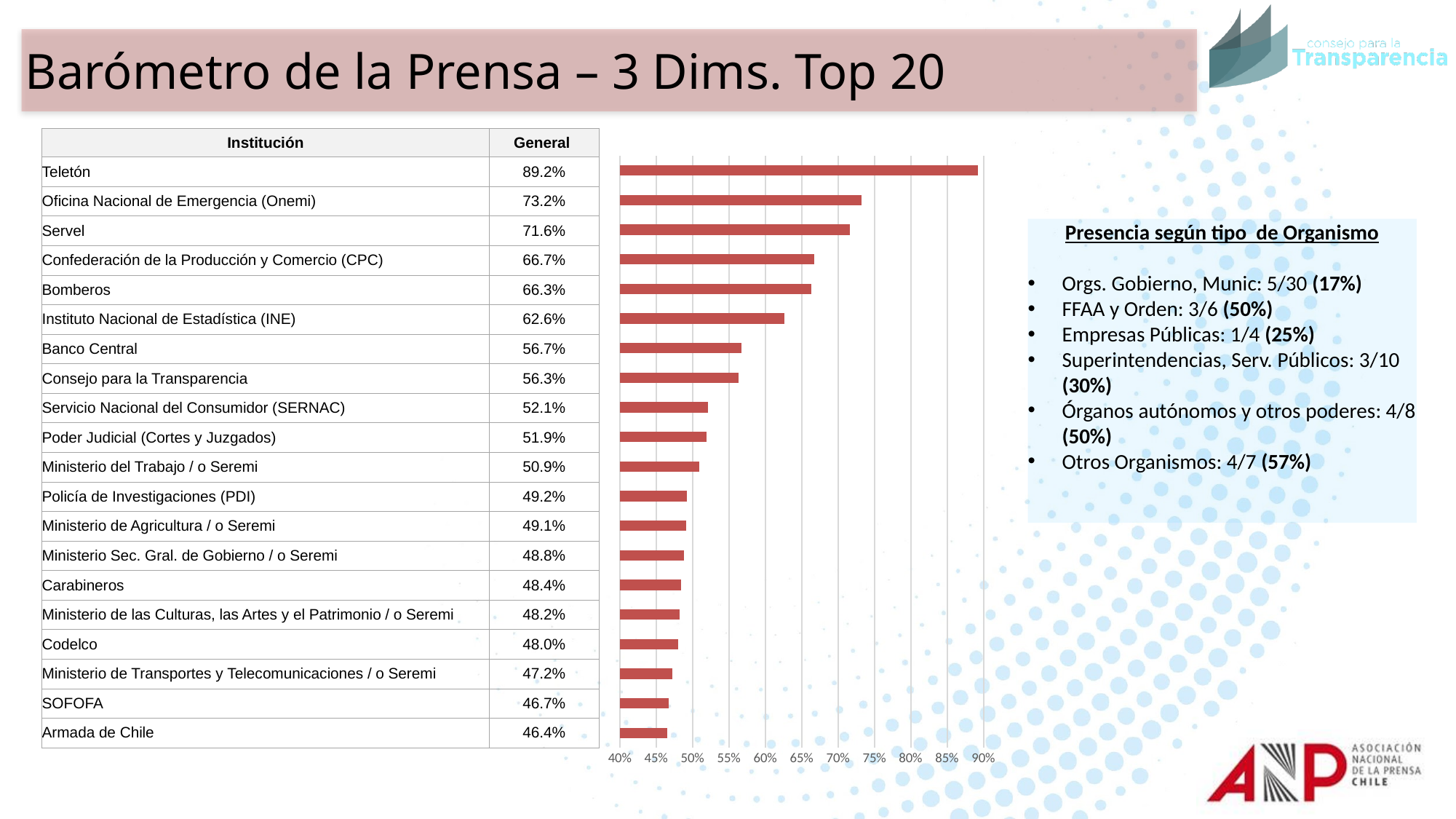
What kind of chart is shown on the slide? bar chart What is the difference between the General values of Teletón and Oficina Nacional de Emergencia (Onemi)? 16.0% What is the General value for Consejo para la Transparencia? 56.3% Do the bar values rise or fall going down the chart from Teletón to Armada de Chile? fall Is the value for Instituto Nacional de Estadística (INE) greater or less than 60%? greater What is the lowest percentage tick shown on the chart's horizontal axis? 40% How many institutions are plotted in the bar chart? 20 Which institution has the lowest General value? Armada de Chile What is the General value for Codelco? 48.0% Which institution has the highest General value? Teletón What is the General value for Servel? 71.6% Which has a larger General value, Bomberos or Banco Central? Bomberos